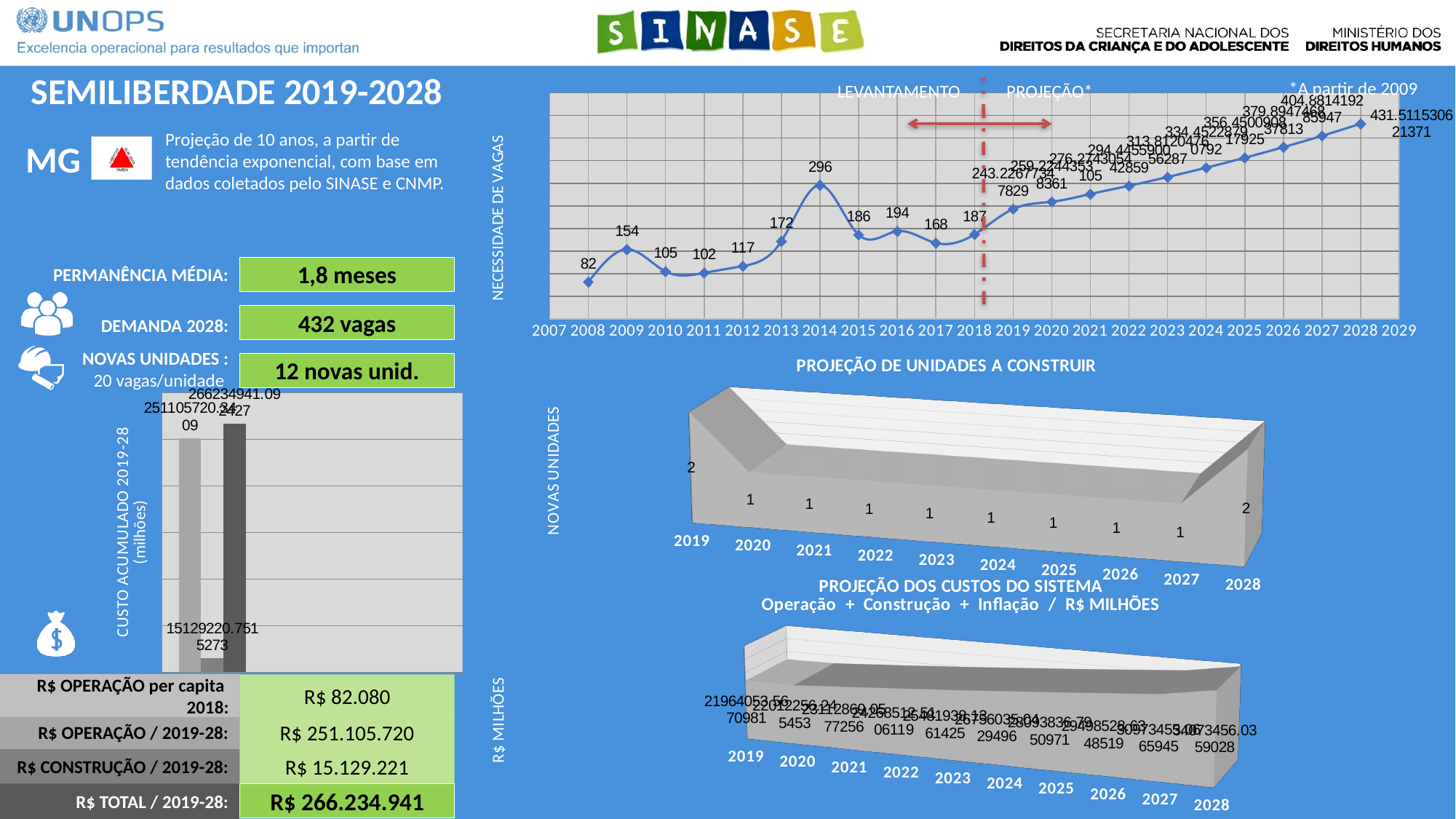
In the chart titled PROJEÇÃO DE UNIDADES A CONSTRUIR, what is the value for 2019? 2 In the chart titled PROJEÇÃO DE UNIDADES A CONSTRUIR, what is the value for 2024? 1 In the top-right line chart (NECESSIDADE DE VAGAS), do the values rise or fall from 2018 to 2028? rise In the top-right line chart (NECESSIDADE DE VAGAS), which year has the highest value? 2028 What kind of chart is the one titled PROJEÇÃO DOS CUSTOS DO SISTEMA? 3D area chart In the top-right line chart (NECESSIDADE DE VAGAS), which year has the lowest value? 2008 In the top-right line chart (NECESSIDADE DE VAGAS), which year has the larger value, 2015 or 2016? 2016 In the top-right line chart (NECESSIDADE DE VAGAS), what is the value for 2008? 82 In the top-right line chart (NECESSIDADE DE VAGAS), what is the value for 2014? 296 What kind of chart is the top-right chart (NECESSIDADE DE VAGAS)? line chart How many years (categories) are shown in the chart titled PROJEÇÃO DE UNIDADES A CONSTRUIR? 10 In the top-right line chart (NECESSIDADE DE VAGAS), what is the difference between the values for 2014 and 2013? 124